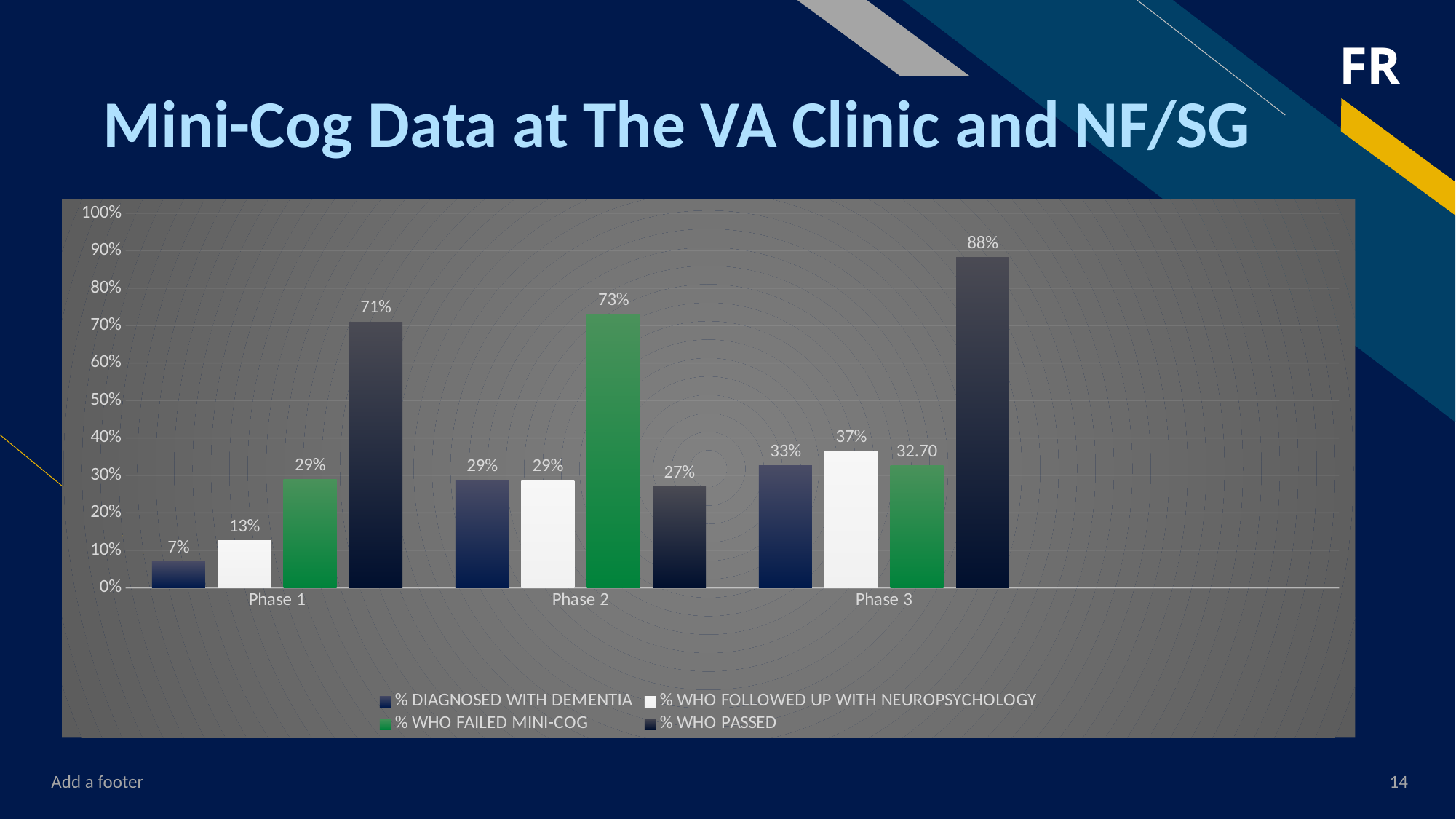
What kind of chart is shown on the slide? Bar chart How many phases are shown on the x axis? 3 What is the difference between % WHO FAILED MINI-COG in Phase 2 and % WHO PASSED in Phase 2? 46% Does % DIAGNOSED WITH DEMENTIA rise or fall from Phase 1 to Phase 3? Rise How many series does the legend list? 4 What is the value for % WHO FOLLOWED UP WITH NEUROPSYCHOLOGY in Phase 2? 29% What is the value for % WHO PASSED in Phase 3? 88% What is the value for % DIAGNOSED WITH DEMENTIA in Phase 1? 7% Which is larger in Phase 1: % WHO PASSED or % WHO FAILED MINI-COG? % WHO PASSED What is the value for % WHO FAILED MINI-COG in Phase 3? 32.70 In which phase is % DIAGNOSED WITH DEMENTIA the lowest? Phase 1 In which phase is % WHO PASSED the highest? Phase 3